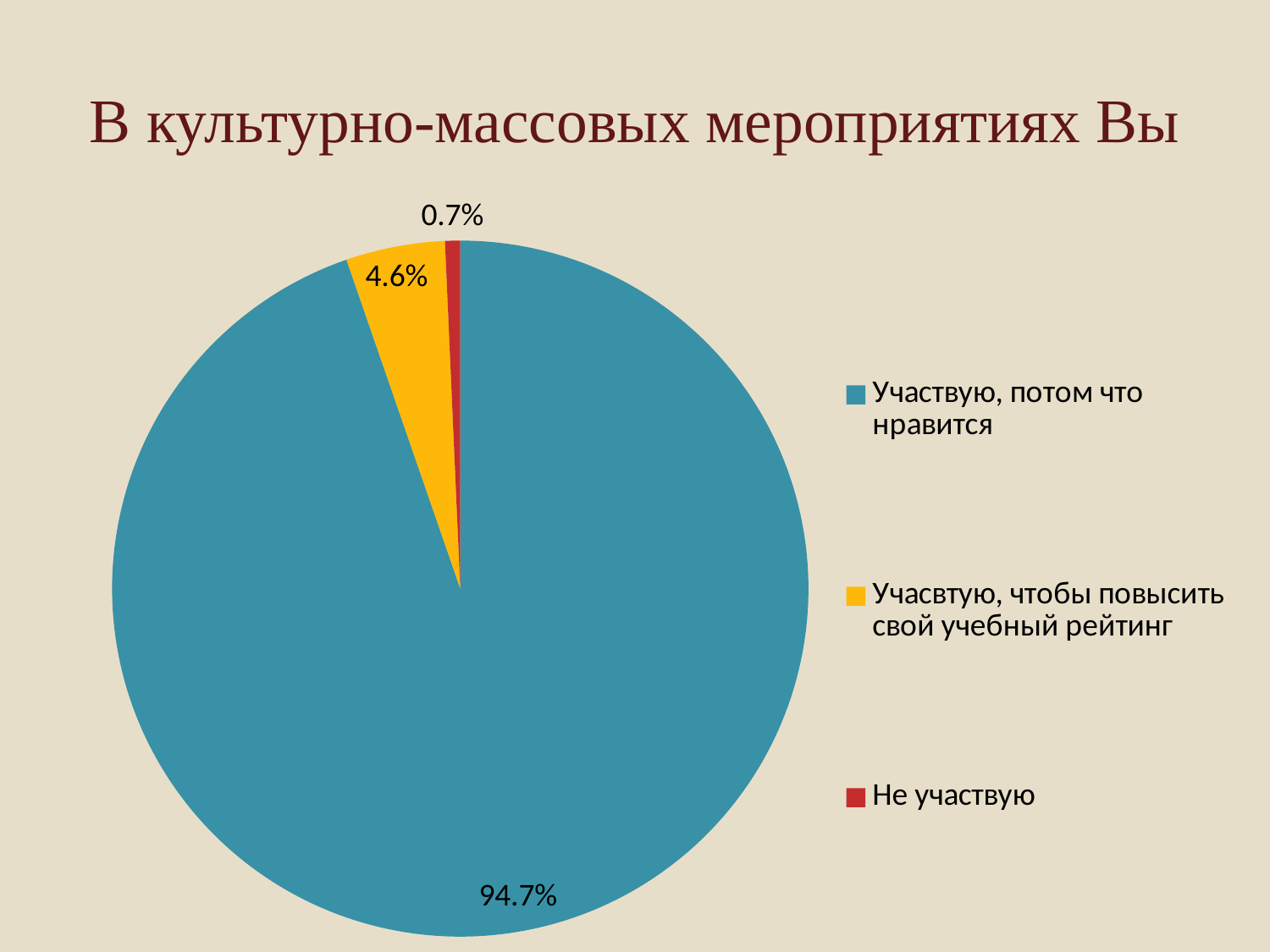
What colour is the slice for "Не участвую"? red What share of the pie is labelled "Учасвтую, чтобы повысить свой учебный рейтинг"? 4.6% What is the title of the chart? В культурно-массовых мероприятиях Вы What share of the pie is labelled "Не участвую"? 0.7% What is the difference in percentage points between "Участвую, потом что нравится" and "Учасвтую, чтобы повысить свой учебный рейтинг"? 90.1 What is the difference in percentage points between "Учасвтую, чтобы повысить свой учебный рейтинг" and "Не участвую"? 3.9 How many categories does the legend list? 3 Which category has the smallest slice of the pie? Не участвую Which is larger: the slice for "Учасвтую, чтобы повысить свой учебный рейтинг" or the slice for "Не участвую"? Учасвтую, чтобы повысить свой учебный рейтинг What type of chart is shown on the slide? pie chart Which category has the largest slice of the pie? Участвую, потом что нравится What share of the pie is labelled "Участвую, потом что нравится"? 94.7%